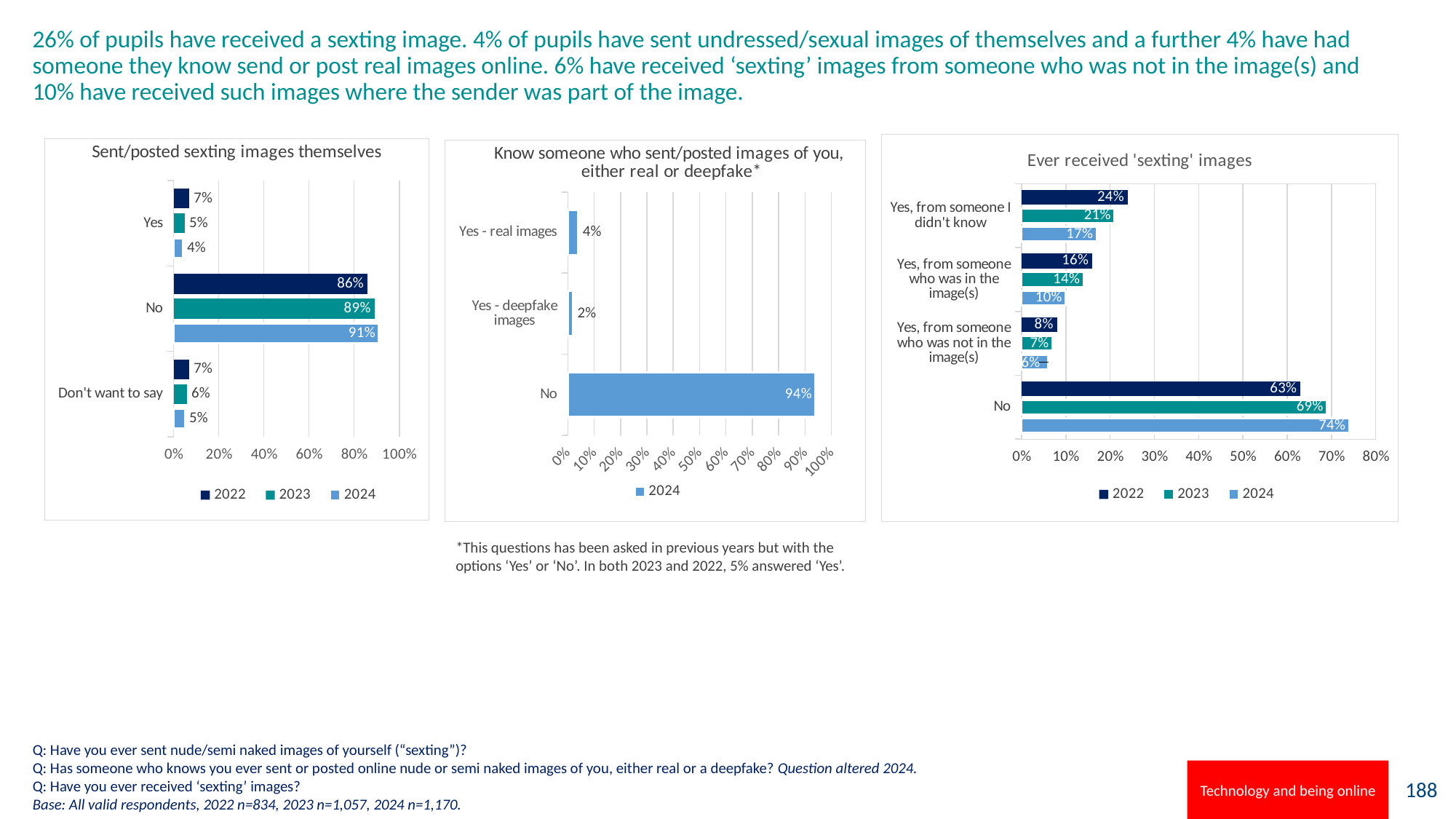
In the 'Ever received 'sexting' images' chart, what is the 2023 value for 'Yes, from someone who was in the image(s)'? 14% In the 'Sent/posted sexting images themselves' chart, what is the 2024 value for 'No'? 91% In the 'Know someone who sent/posted images of you, either real or deepfake' chart, what is the value for 'Yes - deepfake images'? 2% In the 'Sent/posted sexting images themselves' chart, what is the difference between the 2023 and 2022 values for 'No'? 3% In the 'Know someone who sent/posted images of you, either real or deepfake' chart, which category has the highest value? No In the 'Ever received 'sexting' images' chart, what is the 2024 value for 'No'? 74% How many categories are shown in the 'Ever received 'sexting' images' chart? 4 In the 'Ever received 'sexting' images' chart, which is larger for 'Yes, from someone I didn't know': the 2022 value or the 2024 value? 2022 In the 'Sent/posted sexting images themselves' chart, what is the 2022 value for 'Yes'? 7% What kind of chart is the 'Sent/posted sexting images themselves' chart? Bar chart How many series does the legend list in the 'Know someone who sent/posted images of you, either real or deepfake' chart? 1 In the 'Ever received 'sexting' images' chart, what is the difference between the 2024 and 2022 values for 'No'? 11%